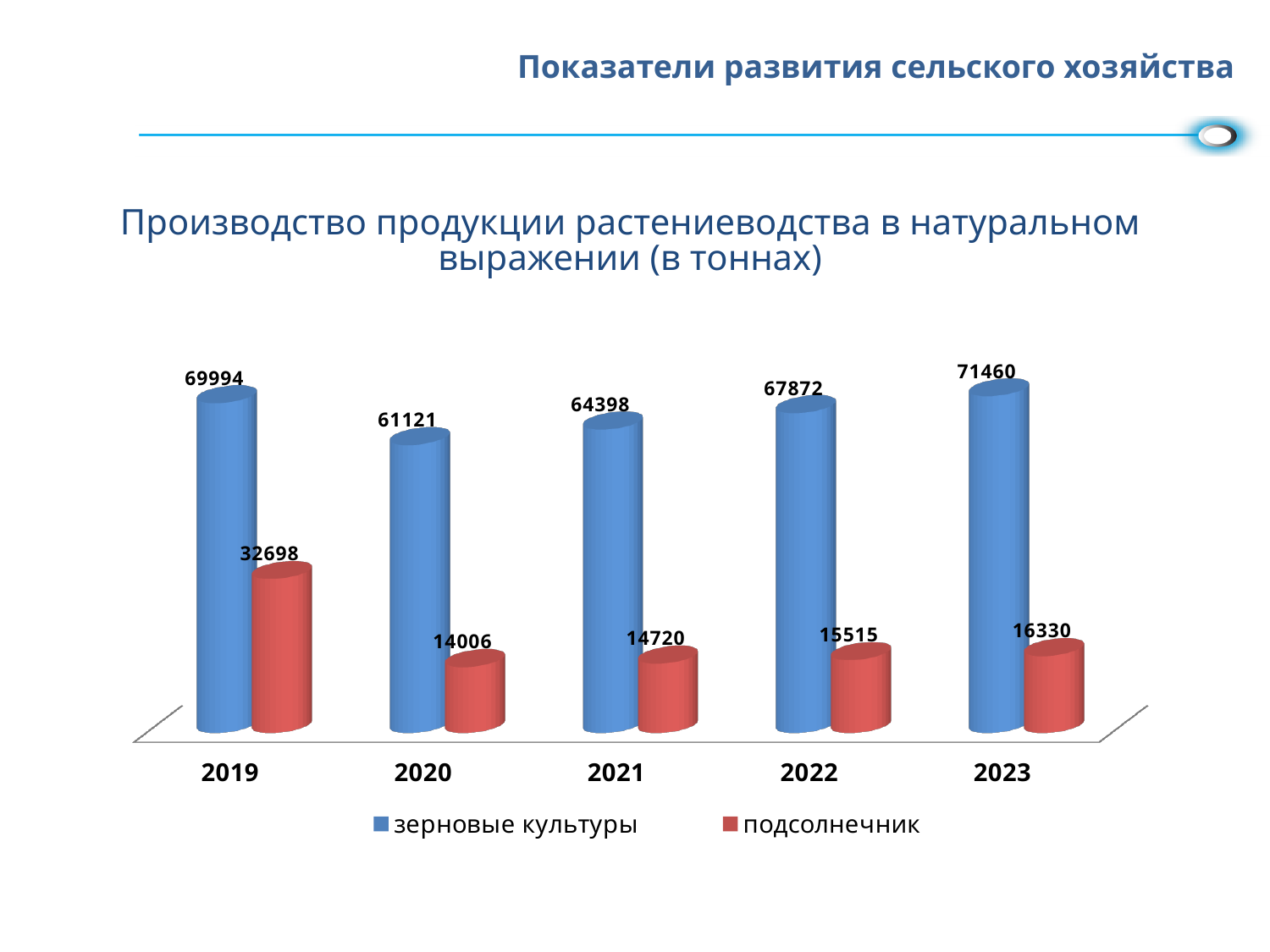
What colour are the bars for подсолнечник? red What is the value for зерновые культуры in 2021? 64398 How many series does the legend list? 2 What kind of chart is shown on the slide? bar chart How many years are shown on the x axis? 5 What is the value for зерновые культуры in 2019? 69994 In which year is the value for подсолнечник the lowest? 2020 What is the value for подсолнечник in 2023? 16330 In which year is the value for зерновые культуры the highest? 2023 Which is larger: подсолнечник in 2019 or подсолнечник in 2021? подсолнечник in 2019 Do the values for зерновые культуры rise or fall from 2020 to 2023? rise What is the difference between зерновые культуры and подсолнечник in 2022? 52357